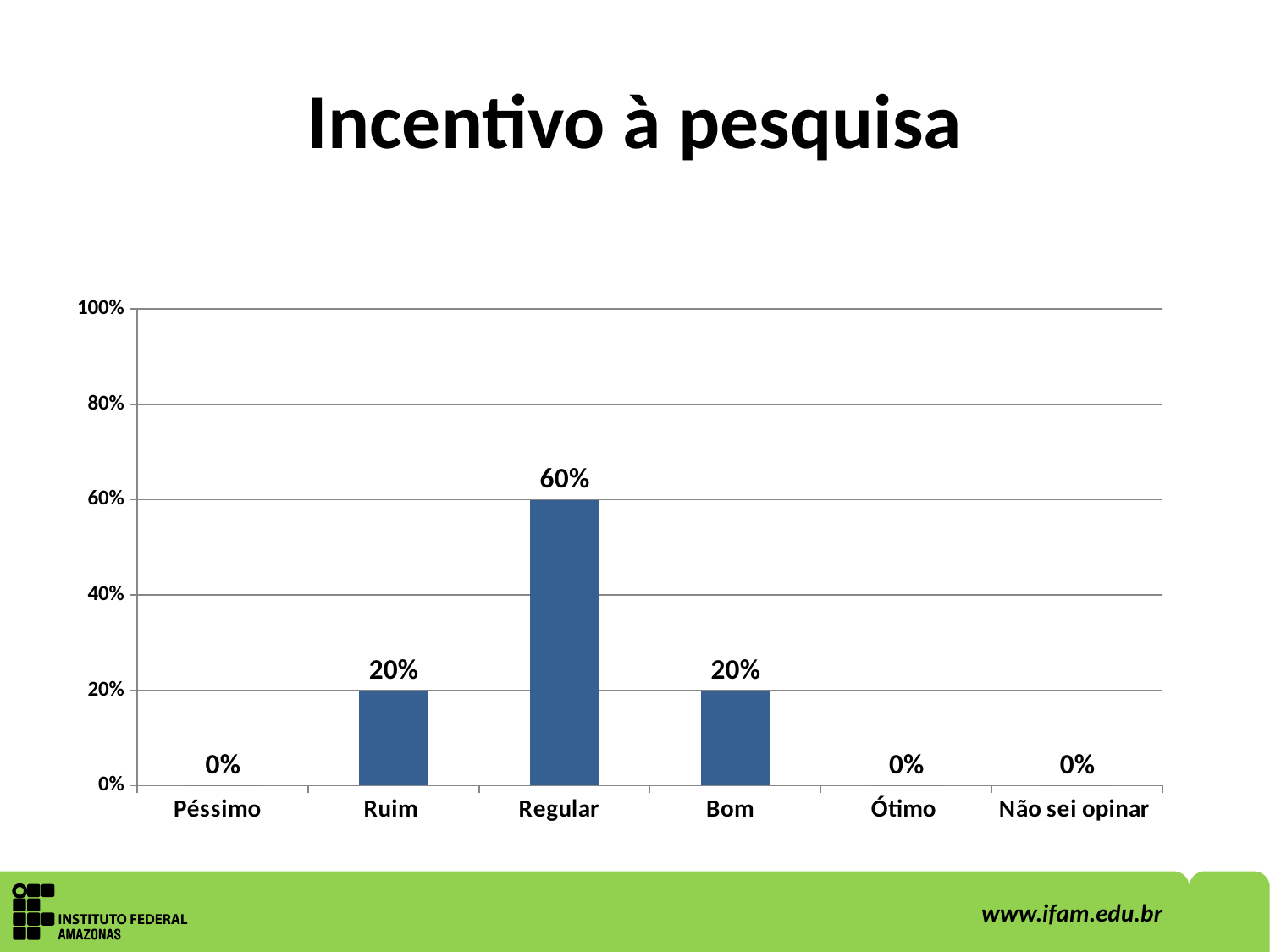
What is the difference between the values for Regular and Bom? 40% What is the value for Bom? 20% What is the value for Não sei opinar? 0% What kind of chart is shown on the slide? bar chart What is the value for Péssimo? 0% What is the value for Ruim? 20% Is the value for Regular greater or less than 40%? greater What is the title of the slide? Incentivo à pesquisa How many categories are shown on the x axis? 6 Which is larger, the value for Regular or the value for Ruim? Regular Which category has the highest value? Regular What is the value for Regular? 60%